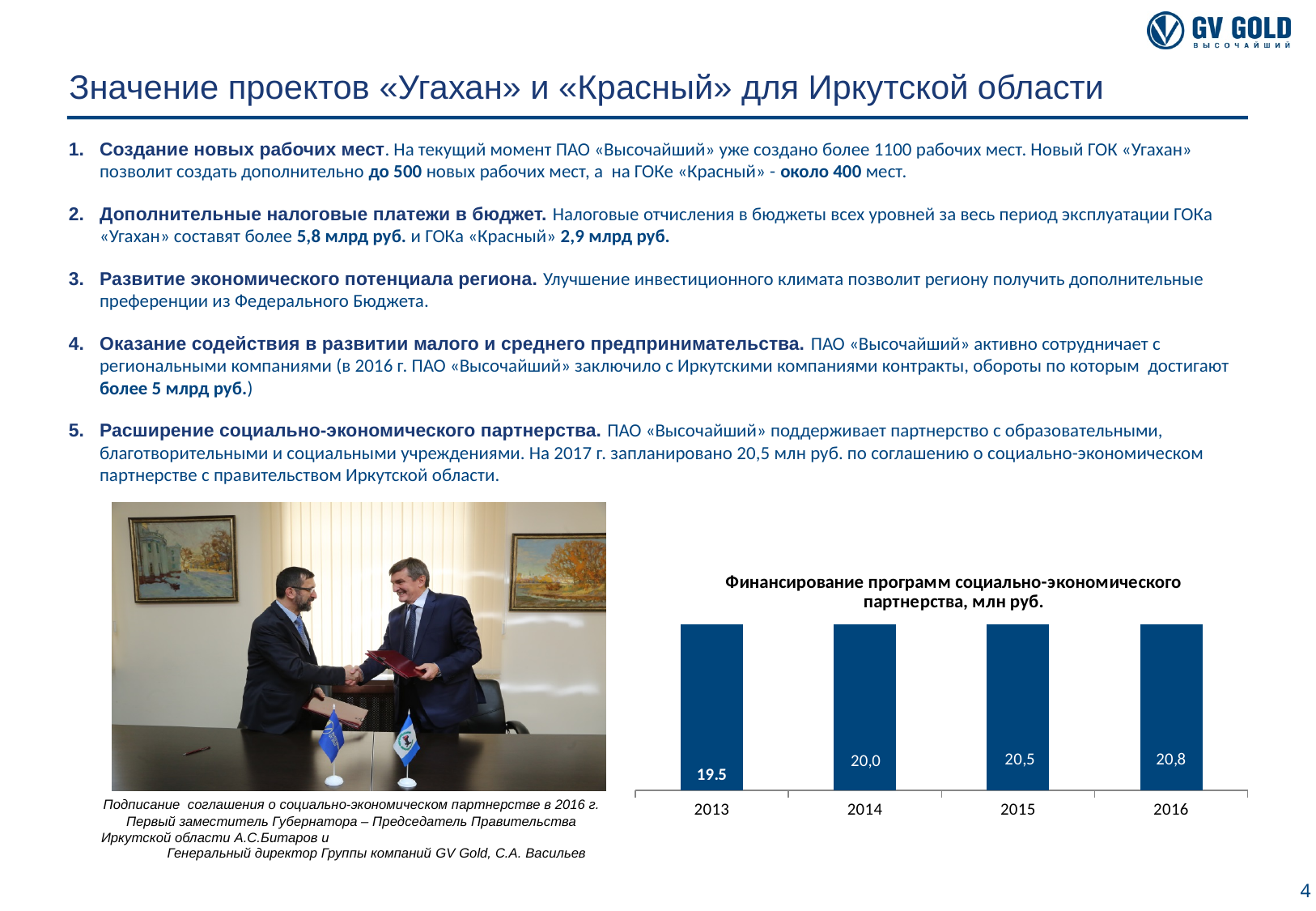
Which year has the highest value in the chart? 2016 What is the value for 2015 in the chart? 20,5 What is the value for 2016 in the chart? 20,8 What is the difference between the values for 2015 and 2014? 0,5 Do the values rise or fall from 2013 to 2016? Rise How many years are shown in the chart? 4 Which year has the lowest value in the chart? 2013 Which is larger, the value for 2014 or the value for 2016? 2016 What kind of chart is shown on the slide? Bar chart What is the difference between the values for 2016 and 2015? 0,3 What is the value for 2014 in the chart? 20,0 What is the value for 2013 in the chart? 19.5